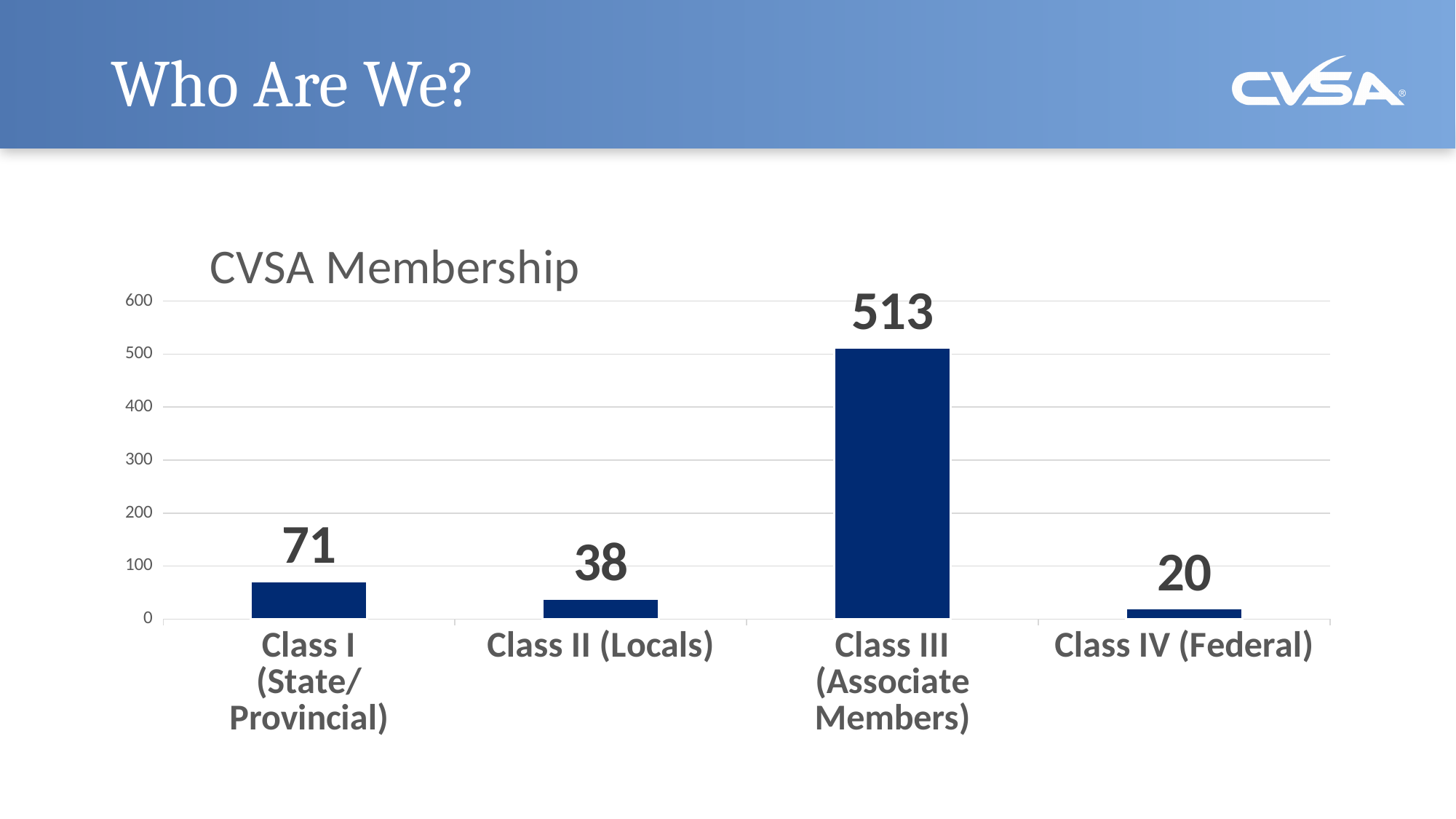
What is the value for Class II (Locals)? 38 What is the difference between the values for Class III (Associate Members) and Class I (State/Provincial)? 442 Which category has the highest value? Class III (Associate Members) Is the value for Class III (Associate Members) greater or less than 500? greater Which category has the lowest value? Class IV (Federal) What is the value for Class I (State/Provincial)? 71 Which is larger, the value for Class II (Locals) or the value for Class IV (Federal)? Class II (Locals) What is the title of the chart? CVSA Membership How many categories are shown in the chart? 4 What is the value for Class III (Associate Members)? 513 What is the value for Class IV (Federal)? 20 What is the difference between the values for Class I (State/Provincial) and Class II (Locals)? 33